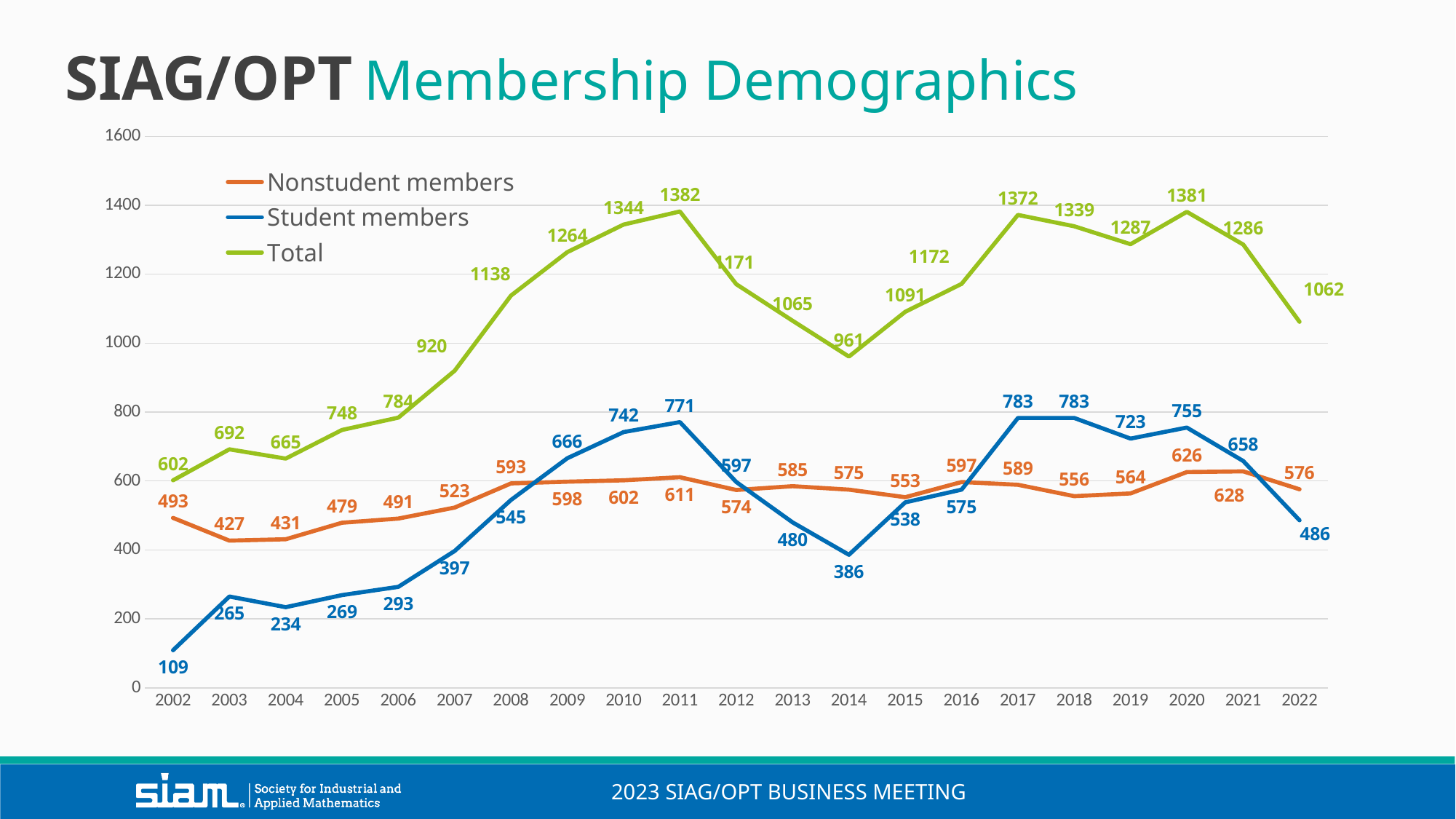
How many series does the legend list? 3 Which colour is used for the Total series? green What type of chart is shown on the slide? line chart What is the difference between Student members and Nonstudent members in 2017? 194 In which year was the Total membership highest? 2011 In which year was the number of Student members lowest? 2002 What was the Total membership in 2014? 961 How many years are plotted along the x axis? 21 Which was larger in 2014, Nonstudent members or Student members? Nonstudent members What was the number of Nonstudent members in 2022? 576 What was the number of Student members in 2011? 771 Did the Total membership rise or fall from 2020 to 2022? fall